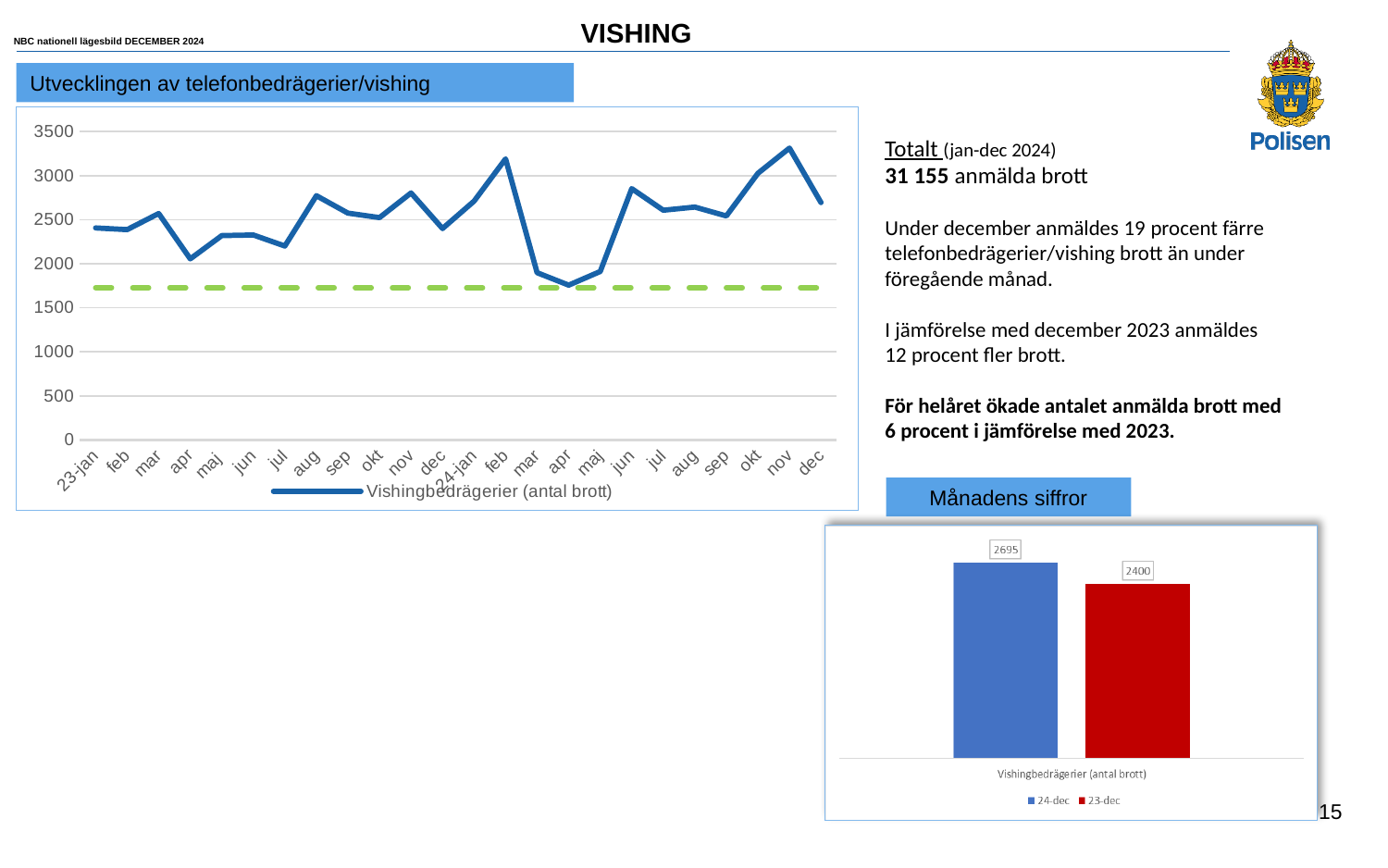
How many series does the legend of the 'Månadens siffror' chart list? 2 In the 'Månadens siffror' bar chart, what is the value for 23-dec? 2400 In the 'Utvecklingen av telefonbedrägerier/vishing' line chart, is the value for 24-mar greater or less than 2000? less In the 'Utvecklingen av telefonbedrägerier/vishing' line chart, which month has the highest value? 24-nov In the 'Utvecklingen av telefonbedrägerier/vishing' line chart, which month has the lowest value? 24-apr What kind of chart is the 'Utvecklingen av telefonbedrägerier/vishing' chart? Line chart How many monthly data points are plotted in the 'Utvecklingen av telefonbedrägerier/vishing' line chart? 24 In the 'Månadens siffror' bar chart, what is the difference between the 24-dec and 23-dec values? 295 In the 'Månadens siffror' bar chart, which is larger, 24-dec or 23-dec? 24-dec In the 'Månadens siffror' bar chart, what is the value for 24-dec? 2695 In the 'Utvecklingen av telefonbedrägerier/vishing' line chart, is the value for 24-feb greater or less than 3000? greater What kind of chart is the 'Månadens siffror' chart? Bar chart